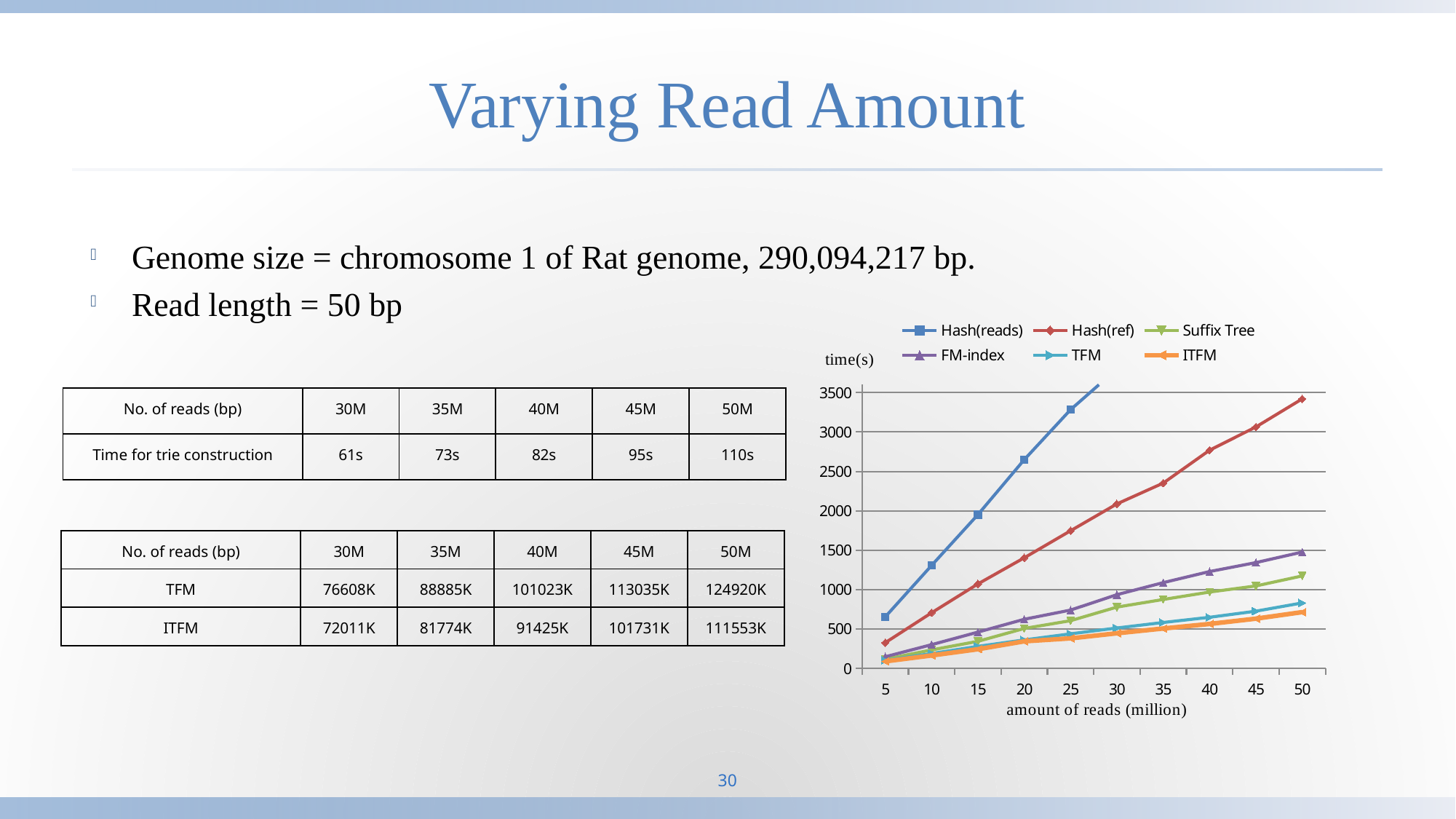
Is the value for TFM at 50 million reads greater or less than 1000? less Which series has the lowest value at 50 million reads? ITFM What kind of chart is shown on the slide? line chart Is the value for Hash(ref) at 50 million reads greater or less than 3000? greater Is the value for Hash(ref) at 25 million reads greater or less than 2000? less Does the Hash(ref) series rise or fall as the amount of reads increases? rises How many points are marked along the x axis of the chart? 10 At 40 million reads, which is larger: FM-index or Suffix Tree? FM-index How many series does the chart legend list? 6 What is the label of the x axis of the chart? amount of reads (million)